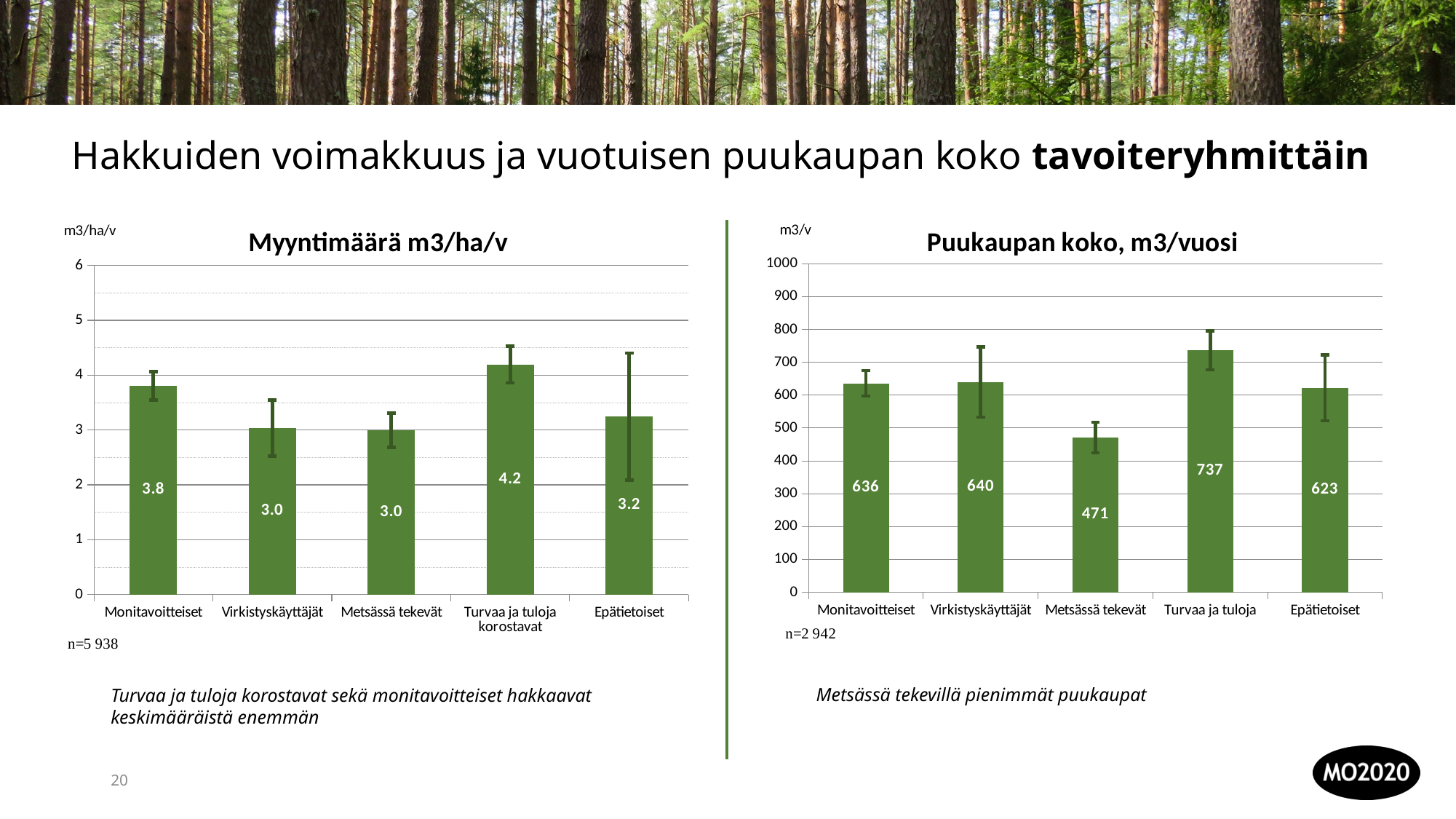
In the 'Puukaupan koko, m3/vuosi' chart, which category has the lowest value? Metsässä tekevät In the 'Myyntimäärä m3/ha/v' chart, which is larger: Monitavoitteiset or Epätietoiset? Monitavoitteiset In the 'Myyntimäärä m3/ha/v' chart, which category has the highest value? Turvaa ja tuloja korostavat In the 'Myyntimäärä m3/ha/v' chart, what is the value for Monitavoitteiset? 3.8 In the 'Puukaupan koko, m3/vuosi' chart, is the value for Epätietoiset greater or less than 500? greater What kind of chart is the 'Puukaupan koko, m3/vuosi' chart? bar chart In the 'Puukaupan koko, m3/vuosi' chart, what is the value for Metsässä tekevät? 471 What is the title of the chart on the left side of the slide? Myyntimäärä m3/ha/v In the 'Myyntimäärä m3/ha/v' chart, what is the difference between Turvaa ja tuloja korostavat and Epätietoiset? 1.0 In the 'Puukaupan koko, m3/vuosi' chart, what is the difference between Turvaa ja tuloja and Metsässä tekevät? 266 In the 'Puukaupan koko, m3/vuosi' chart, which category has the highest value? Turvaa ja tuloja In the 'Myyntimäärä m3/ha/v' chart, how many categories are shown? 5